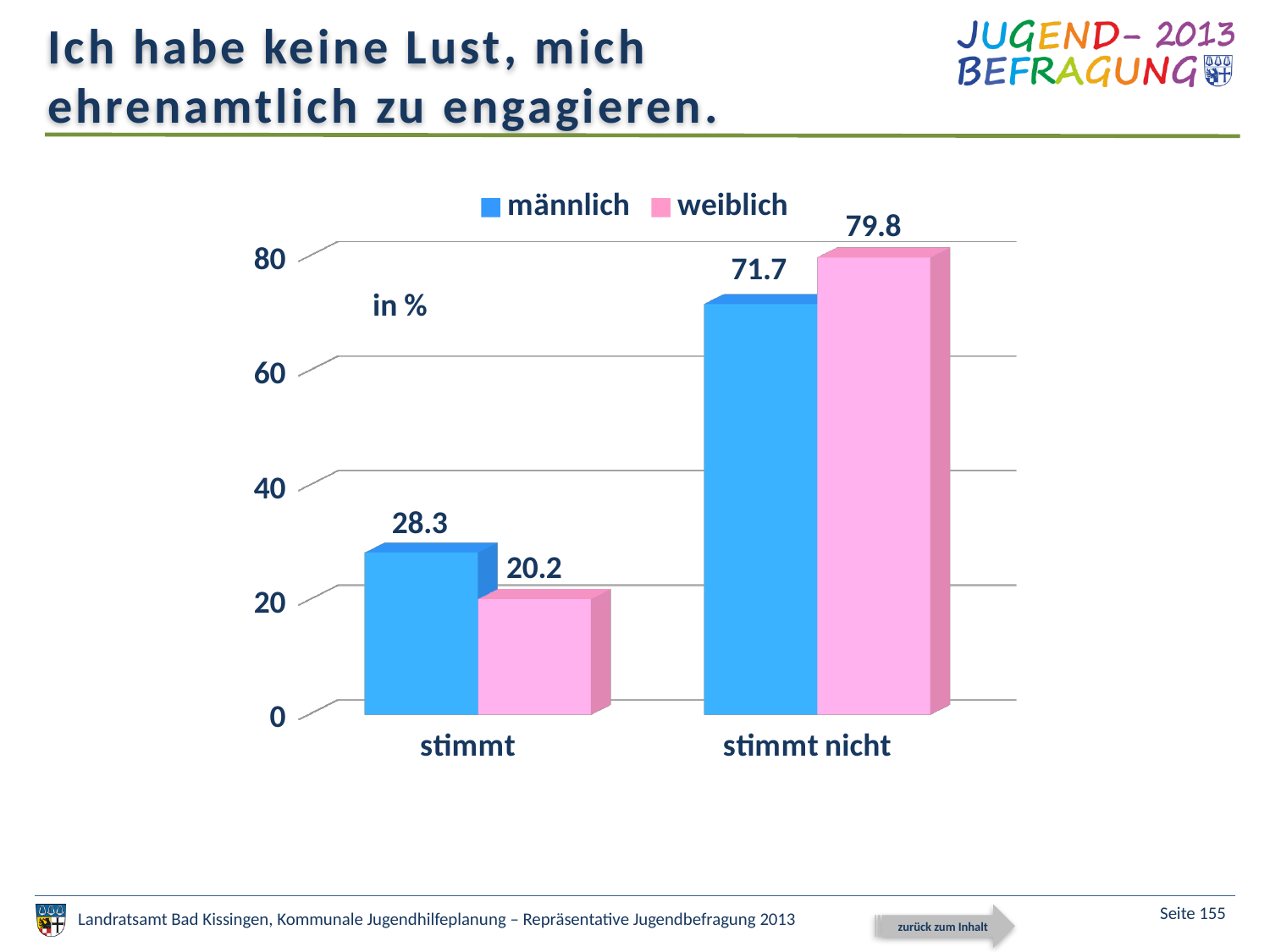
Which series has the lowest value in the stimmt category? weiblich How many series does the legend list? 2 What is the difference between the männlich and weiblich values in the stimmt category? 8.1 What is the value for weiblich in the stimmt category? 20.2 What kind of chart is shown on the slide? bar chart What is the difference between the weiblich and männlich values in the stimmt nicht category? 8.1 Which series has the highest value in the stimmt nicht category? weiblich Which is larger: the männlich value for stimmt or the männlich value for stimmt nicht? stimmt nicht What is the value for männlich in the stimmt category? 28.3 How many categories are shown on the x axis? 2 What is the value for männlich in the stimmt nicht category? 71.7 What is the value for weiblich in the stimmt nicht category? 79.8